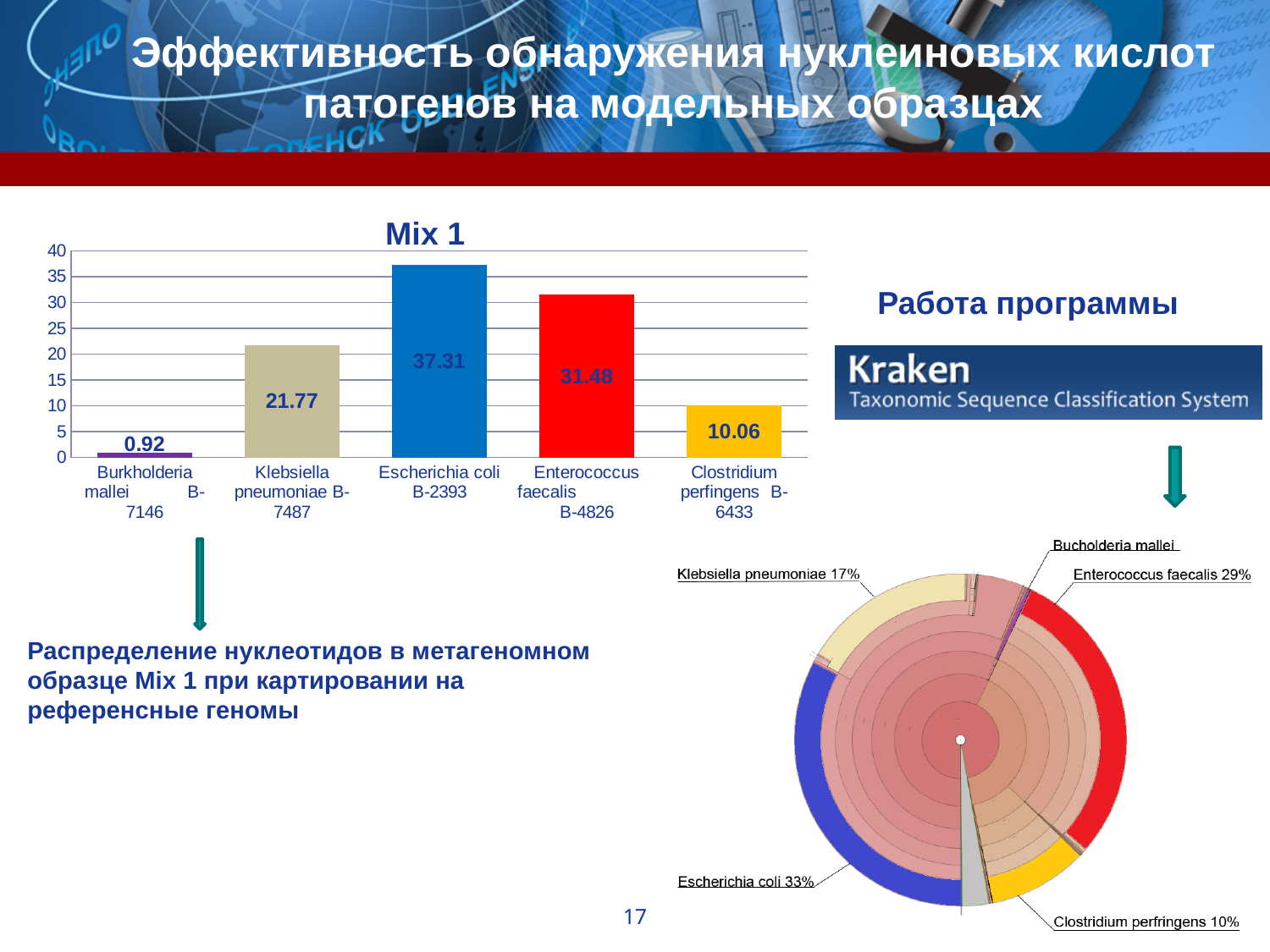
In the Mix 1 bar chart, which category has the lowest value? Burkholderia mallei B-7146 In the Mix 1 bar chart, what is the difference between the values for Escherichia coli B-2393 and Enterococcus faecalis B-4826? 5.83 In the Kraken chart at the bottom right, what percentage is shown for Escherichia coli? 33% In the Mix 1 bar chart, what is the value for Clostridium perfingens B-6433? 10.06 In the Mix 1 bar chart, what is the value for Burkholderia mallei B-7146? 0.92 In the Mix 1 bar chart, is the value for Enterococcus faecalis B-4826 greater or less than 30? greater How many categories are shown in the Mix 1 bar chart? 5 What kind of chart is the Mix 1 chart? bar chart In the Mix 1 bar chart, which category has the highest value? Escherichia coli B-2393 In the Mix 1 bar chart, which is larger: the value for Klebsiella pneumoniae B-7487 or the value for Clostridium perfingens B-6433? Klebsiella pneumoniae B-7487 In the Kraken chart at the bottom right, what percentage is shown for Enterococcus faecalis? 29% In the Mix 1 bar chart, what is the value for Escherichia coli B-2393? 37.31